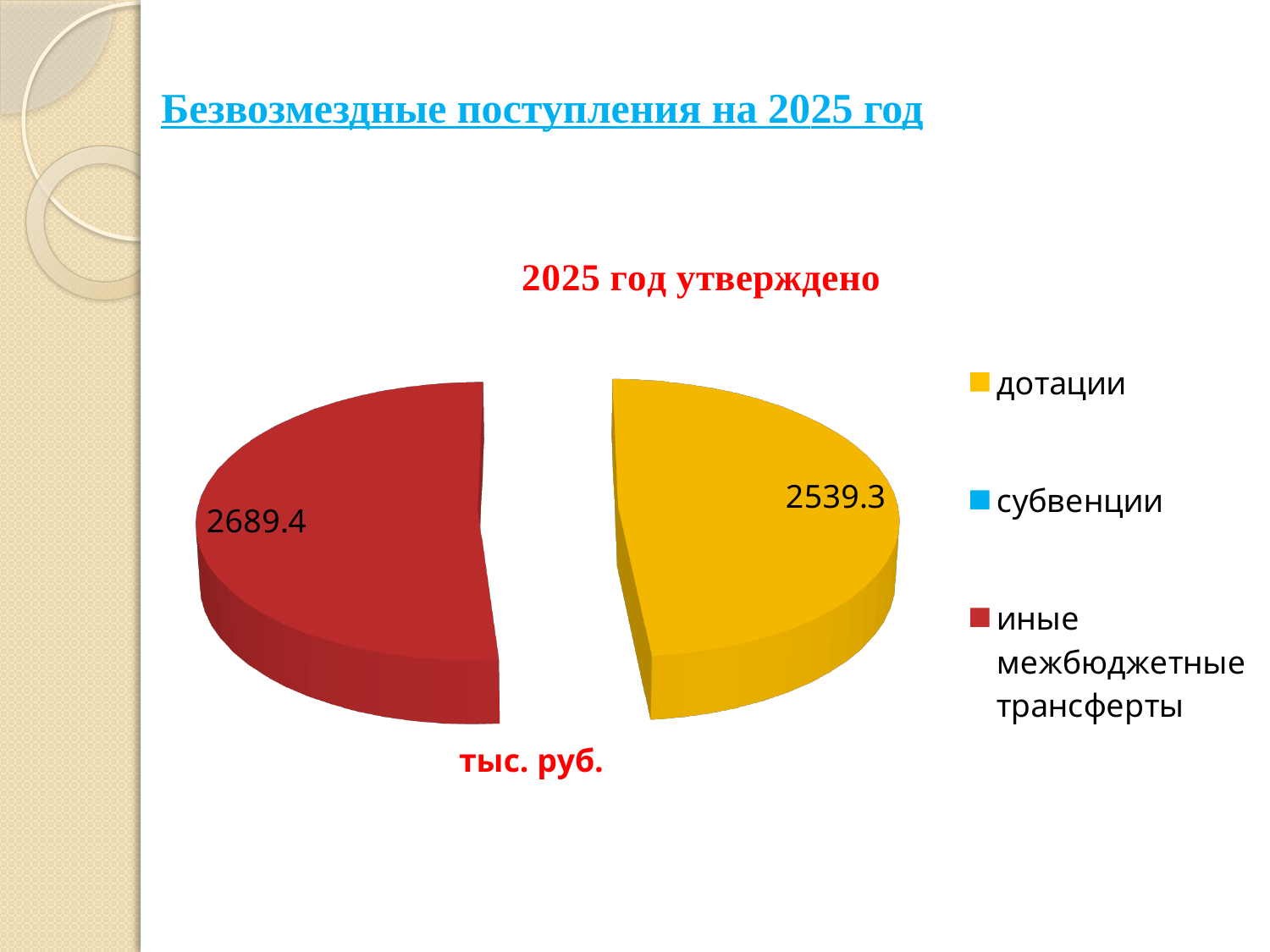
What is the title of the chart? 2025 год утверждено Which category has the largest slice on the pie chart? иные межбюджетные трансферты Which is larger: the value for дотации or the value for иные межбюджетные трансферты? иные межбюджетные трансферты How many slices with data labels are visible on the pie chart? 2 What is the value for иные межбюджетные трансферты on the pie chart? 2689.4 What is the difference between the values for иные межбюджетные трансферты and дотации? 150.1 How many entries does the legend list? 3 Which of the labelled slices has the smaller value? дотации What unit is shown below the pie chart? тыс. руб. What kind of chart is shown on the slide? pie chart What is the value for дотации on the pie chart? 2539.3